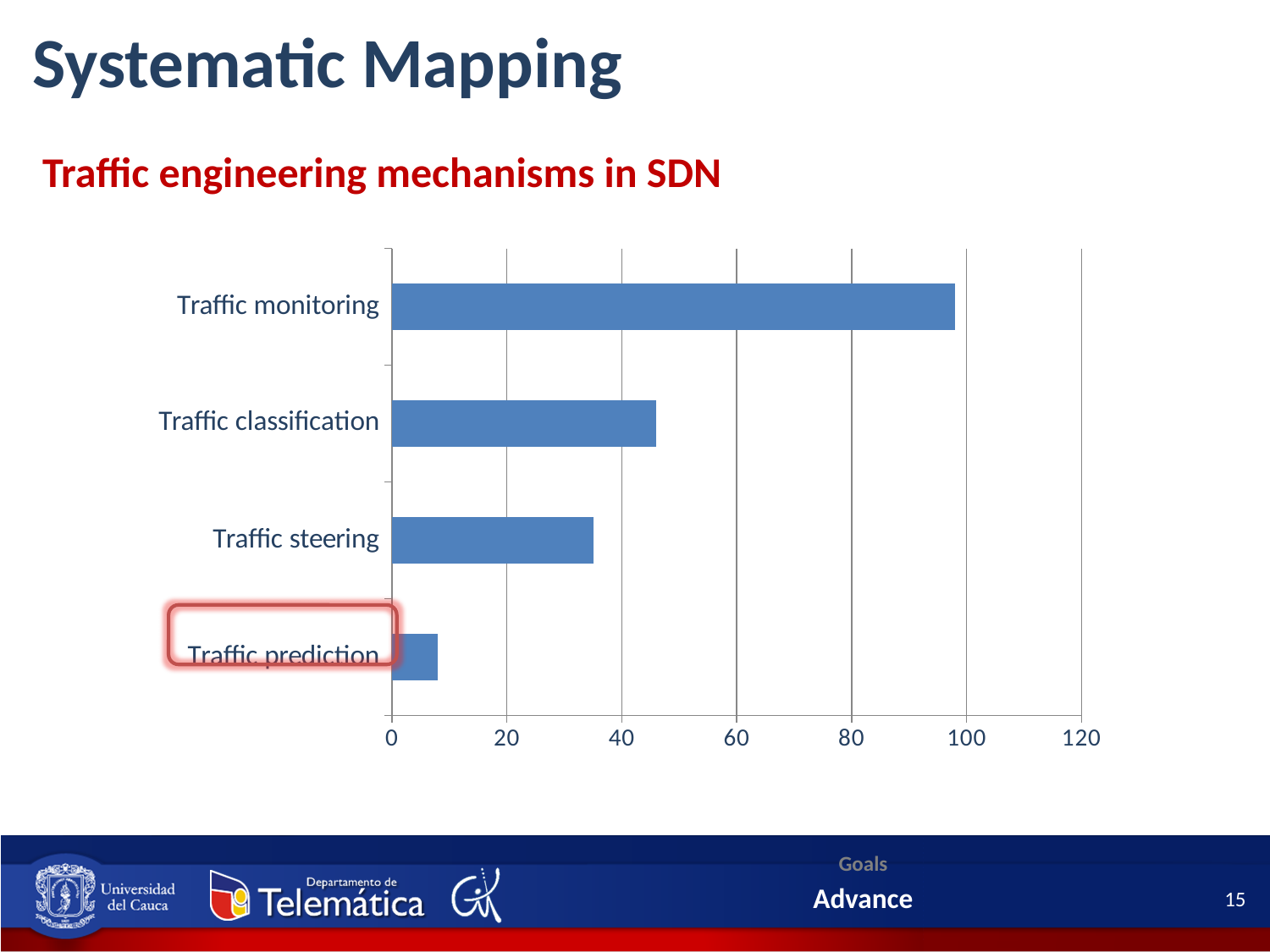
What kind of chart is shown on the slide? bar chart Is the value for Traffic prediction greater or less than 20? less Which is larger, the value for Traffic monitoring or the value for Traffic classification? Traffic monitoring Which category has the lowest value? Traffic prediction How many categories are plotted in the chart? 4 Is the value for Traffic monitoring greater or less than 80? greater Which category has the highest value? Traffic monitoring Is the value for Traffic monitoring greater or less than 100? less Which is larger, the value for Traffic classification or the value for Traffic steering? Traffic classification What is the highest tick value shown on the horizontal axis? 120